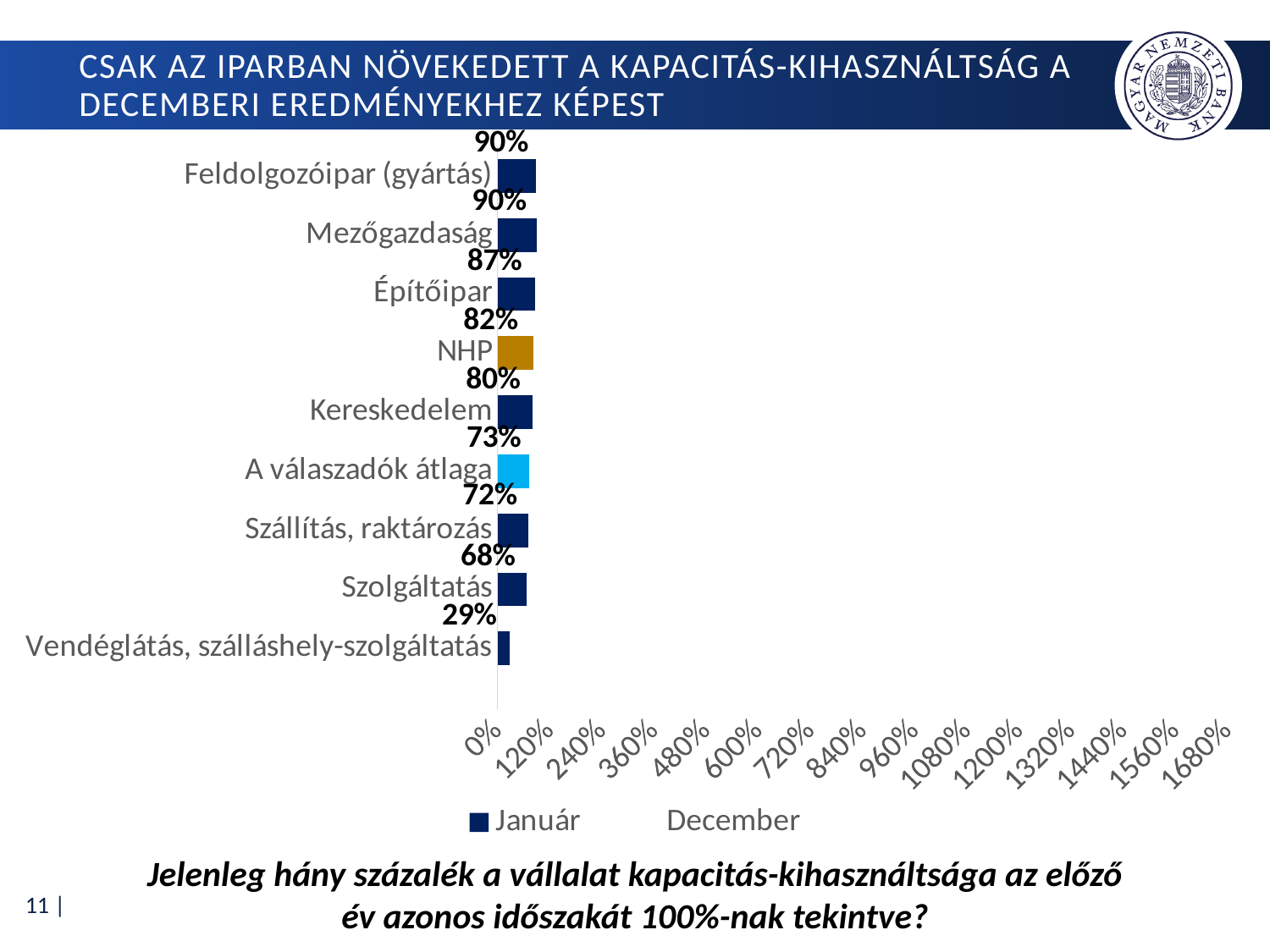
How many series does the legend list? 2 What is the value for Építőipar? 87% What are the two series names listed in the legend? Január and December What is the value for Kereskedelem? 80% What kind of chart is shown on the slide? bar chart How many categories are shown on the chart? 9 Which category has the lowest value? Vendéglátás, szálláshely-szolgáltatás What is the value for A válaszadók átlaga? 73% What is the difference between the values for Szállítás, raktározás and Szolgáltatás? 4% What is the value for Vendéglátás, szálláshely-szolgáltatás? 29% What is the value for NHP? 82% Which is larger, the value for Mezőgazdaság or the value for Kereskedelem? Mezőgazdaság